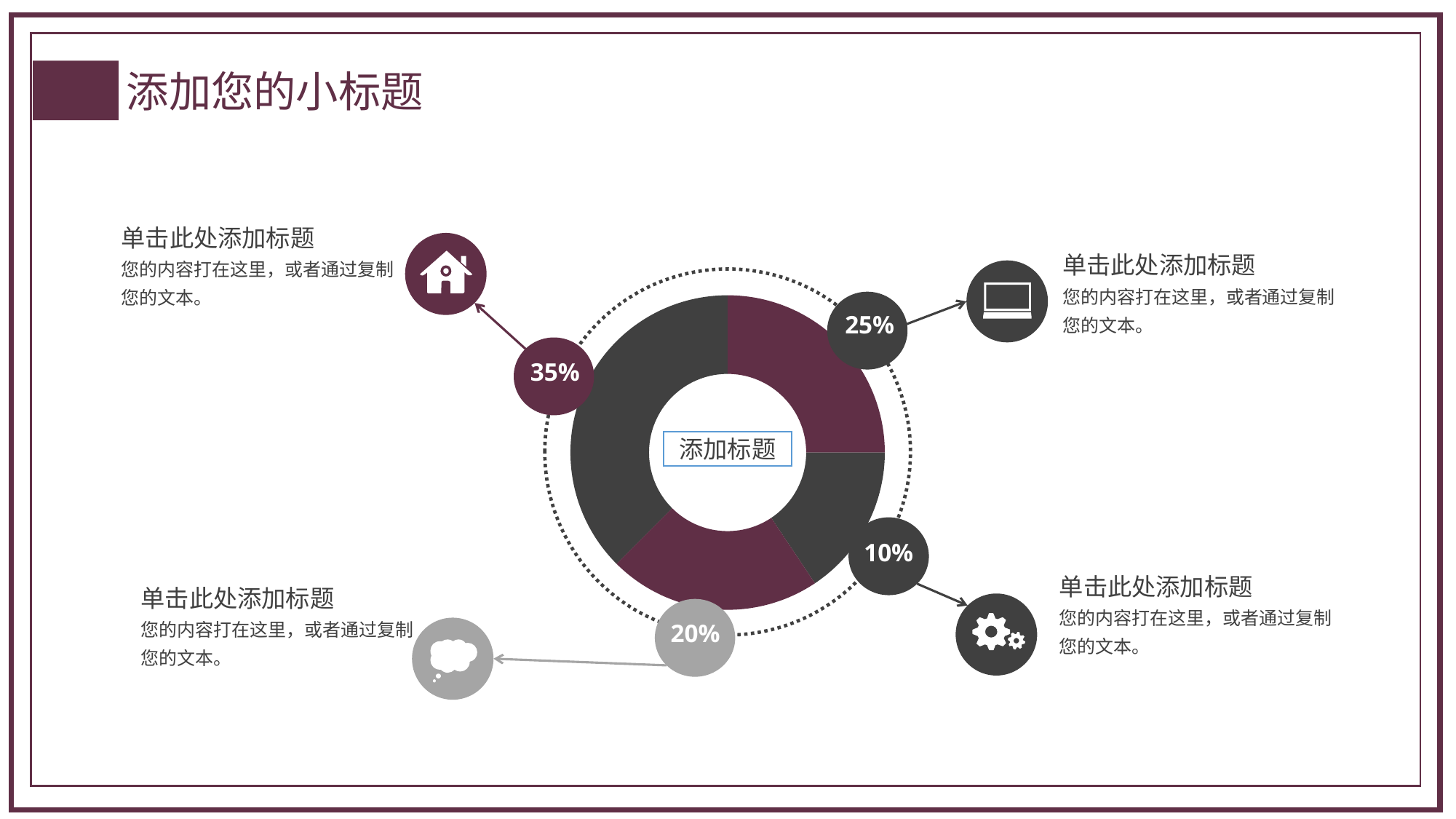
What is the difference between the largest and smallest labelled percentages on the donut chart? 25 percentage points What do the four labelled percentages on the donut chart add up to? 90% How many segments does the donut chart have? 4 What text appears in the centre of the donut chart? 添加标题 What is the smallest percentage labelled on the donut chart? 10% What percentage is shown for the segment linked to the house icon? 35% What kind of chart is shown on the slide? donut (pie) chart What is the largest percentage labelled on the donut chart? 35% What percentage is shown for the segment linked to the gear icon? 10% What percentage is shown for the segment linked to the laptop icon? 25% Which is larger: the segment linked to the laptop icon or the segment linked to the thought-bubble icon? the laptop icon segment (25%) What percentage is shown for the segment linked to the thought-bubble icon? 20%